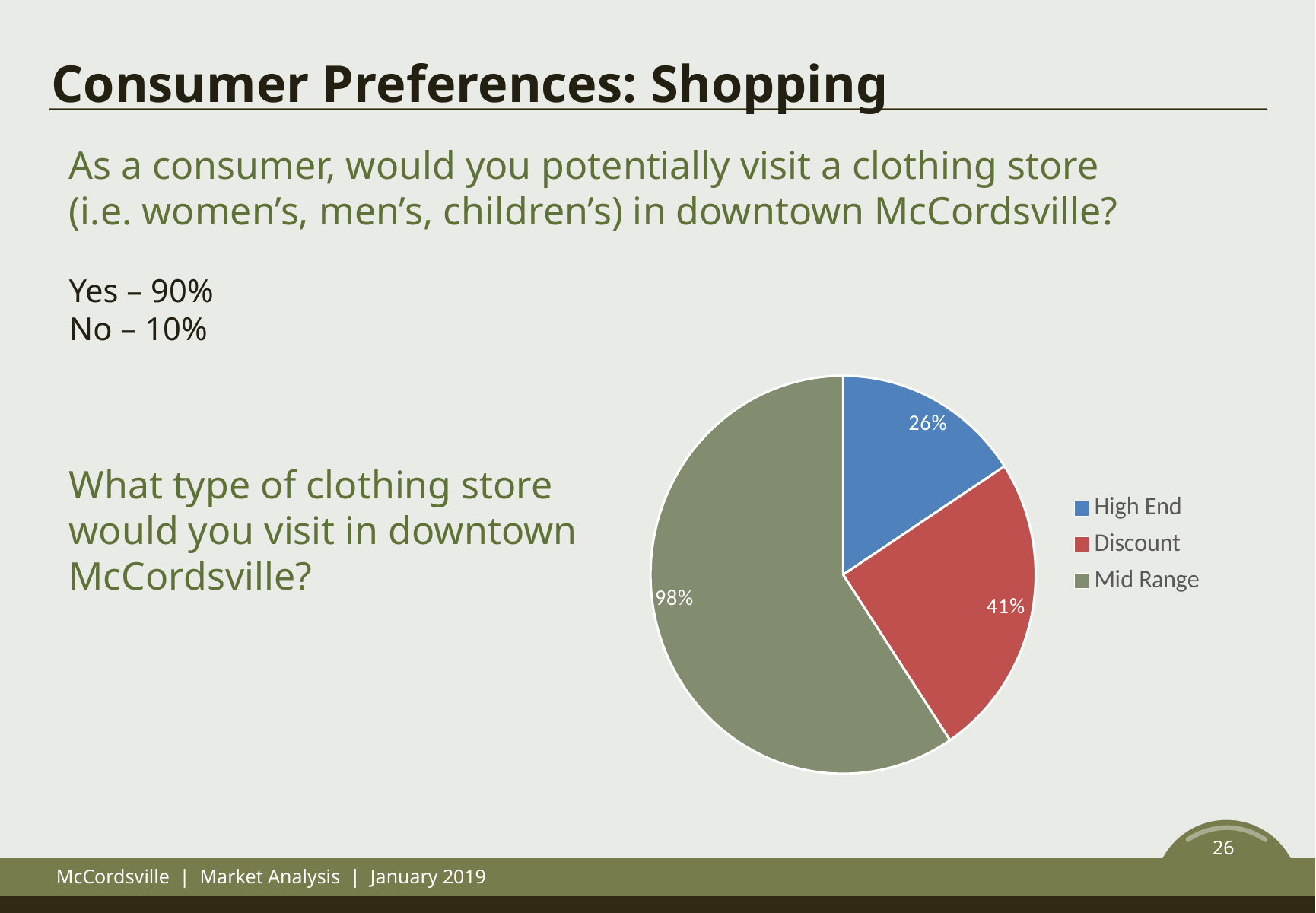
What value is shown for the Mid Range slice of the pie chart? 98% How many entries does the pie chart's legend list? 3 How many slices does the pie chart have? 3 Which category has the smallest slice in the pie chart? High End What is the difference between the values shown for Mid Range and High End in the pie chart? 72% Which category has the largest slice in the pie chart? Mid Range What is the difference between the values shown for Discount and High End in the pie chart? 15% What value is shown for the Discount slice of the pie chart? 41% What kind of chart is shown on the slide? Pie chart Which is larger in the pie chart, Discount or High End? Discount What value is shown for the High End slice of the pie chart? 26% What colour is the Mid Range slice in the pie chart? Green